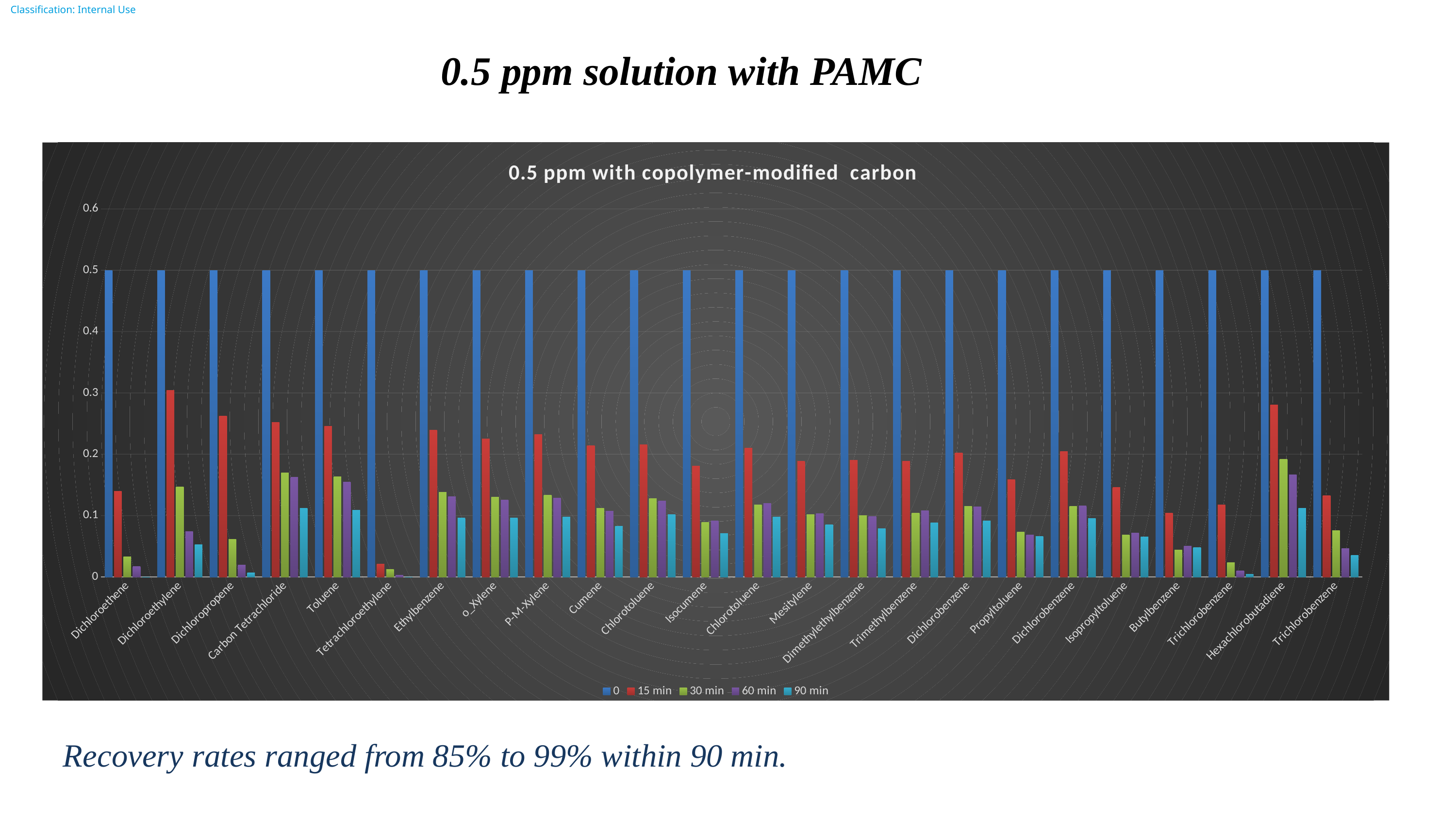
How many categories are shown on the x axis? 24 Which category has the lowest value for the 15 min series? Tetrachloroethylene How many series does the legend list? 5 What is the value of the '0' series for Toluene? 0.5 For the 15 min series, which is larger: Dichloroethylene or Dichloroethene? Dichloroethylene Is the 15 min value for Dichloroethylene greater or less than 0.2? greater Is the 15 min value for Tetrachloroethylene greater or less than 0.1? less Is the 30 min value for Carbon Tetrachloride greater or less than 0.1? greater What is the title of the chart? 0.5 ppm with copolymer-modified carbon What kind of chart is shown on the slide? bar chart